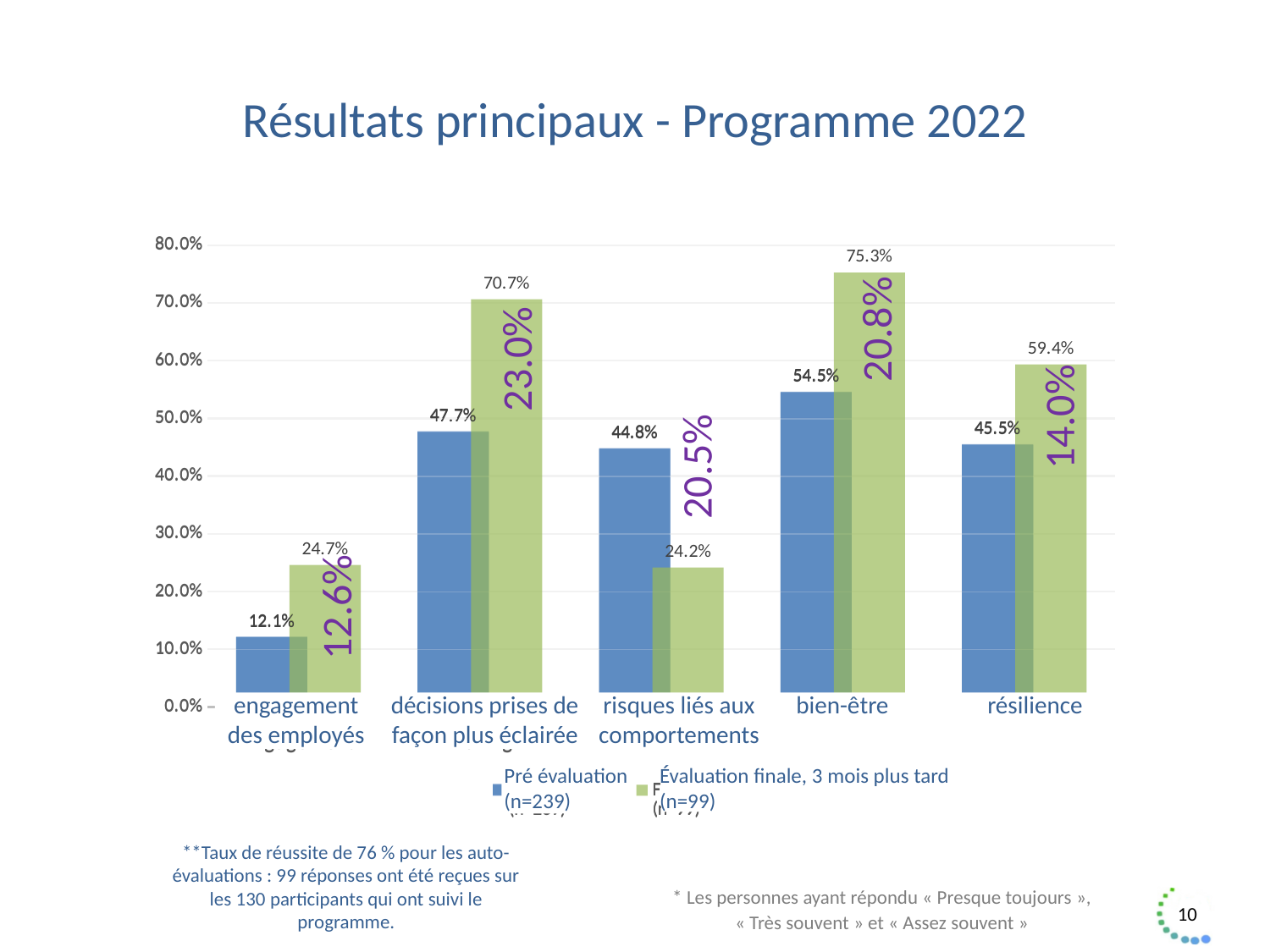
What is the difference between the Évaluation finale and Pré évaluation values for engagement des employés? 12.6% What kind of chart is shown on the slide? bar chart What is the difference between the Évaluation finale and Pré évaluation values for bien-être? 20.8% How many series does the legend list? 2 What is the Évaluation finale, 3 mois plus tard (n=99) value for résilience? 59.4% How many categories are shown on the x axis? 5 For risques liés aux comportements, which is larger: the Pré évaluation value or the Évaluation finale value? Pré évaluation (n=239) What is the Pré évaluation (n=239) value for engagement des employés? 12.1% Which category has the lowest Pré évaluation (n=239) value? engagement des employés Which category has the highest Évaluation finale, 3 mois plus tard (n=99) value? bien-être What is the Pré évaluation (n=239) value for bien-être? 54.5% What is the Évaluation finale, 3 mois plus tard (n=99) value for décisions prises de façon plus éclairée? 70.7%